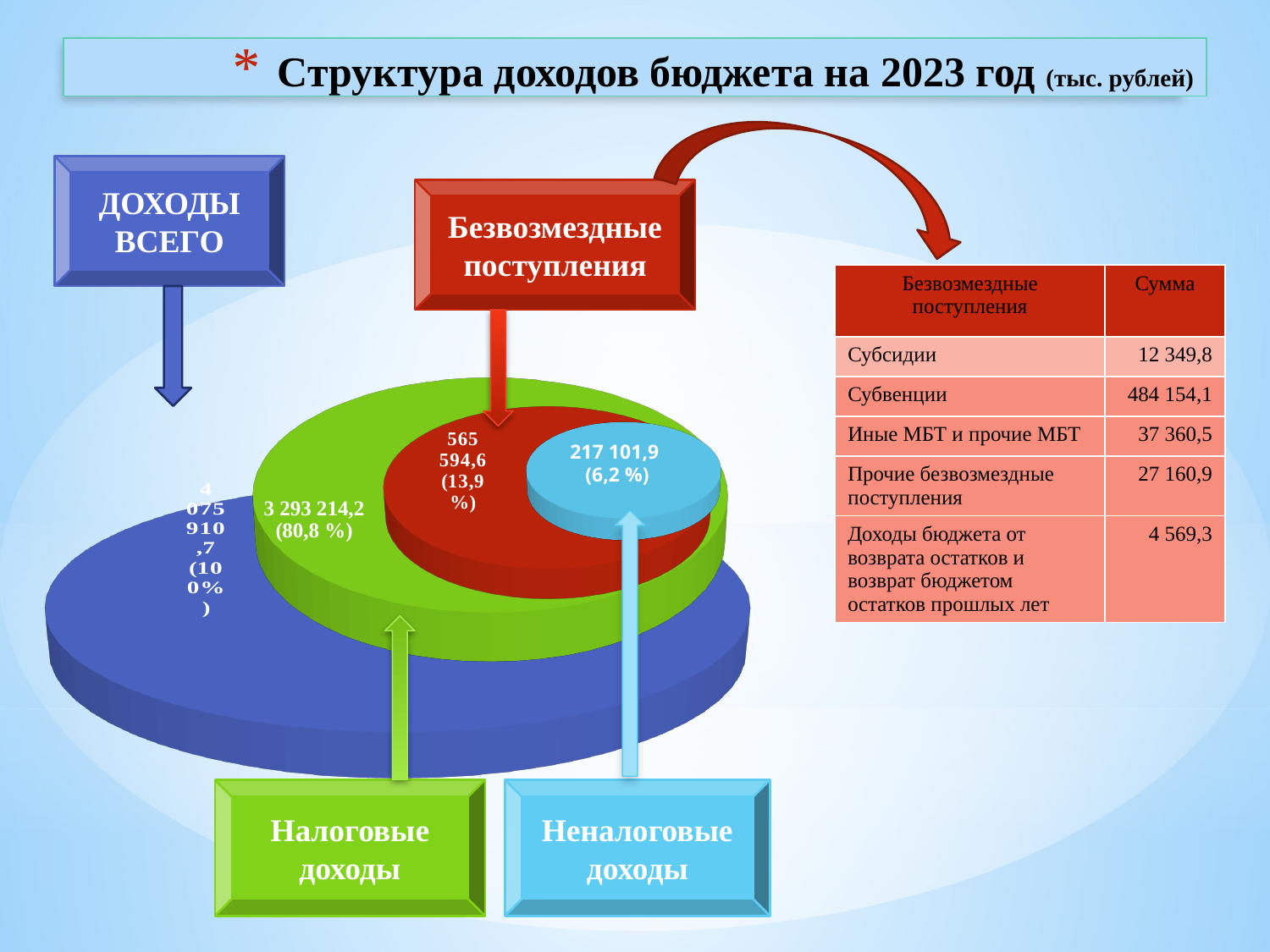
Which is larger on the chart: Безвозмездные поступления or Неналоговые доходы? Безвозмездные поступления What is the value shown for Налоговые доходы on the chart? 3 293 214,2 What is the difference between Безвозмездные поступления and Неналоговые доходы on the chart? 348 492,7 What is the total value shown for Доходы всего on the chart? 4 075 910,7 How many income components (excluding the total) are shown on the chart? 3 Which income component has the largest value on the chart? Налоговые доходы What share of total income do Неналоговые доходы make up according to the chart? 6,2 % In what units are the values on the chart given, according to the slide title? тыс. рублей What is the value shown for Безвозмездные поступления on the chart? 565 594,6 What share of total income do Налоговые доходы make up according to the chart? 80,8 % What is the value shown for Неналоговые доходы on the chart? 217 101,9 Which income component has the smallest value on the chart? Неналоговые доходы